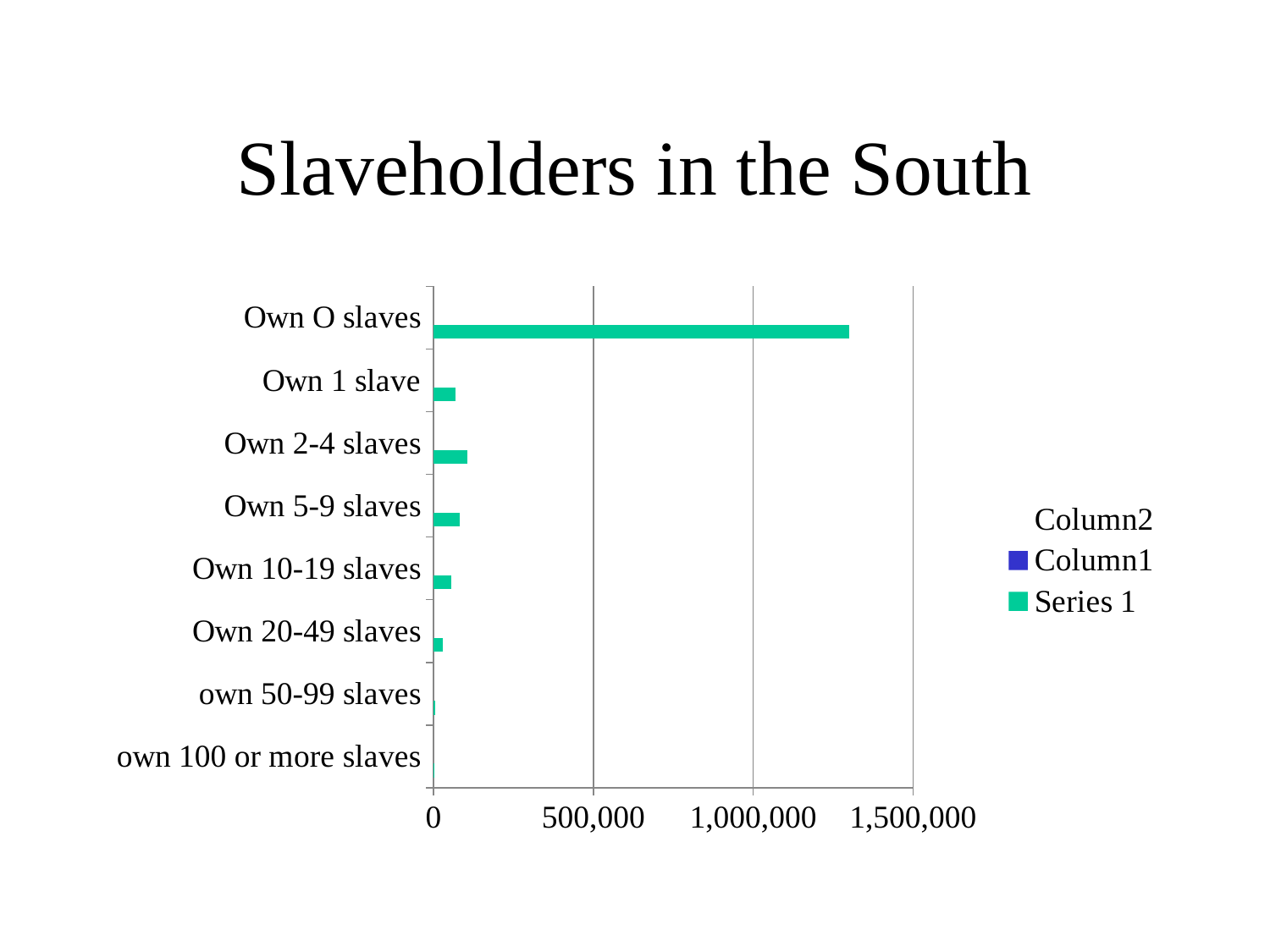
How many series does the legend list? 3 Which is larger, the value for Own 10-19 slaves or the value for Own 20-49 slaves? Own 10-19 slaves What is the title of the chart? Slaveholders in the South Is the value for Own O slaves greater or less than 1,000,000? greater Which category has the highest value? Own O slaves Which is larger, the value for Own 1 slave or the value for Own 2-4 slaves? Own 2-4 slaves Which is larger, the value for Own O slaves or the value for Own 5-9 slaves? Own O slaves Which legend entry do the plotted bars belong to? Series 1 What kind of chart is shown on the slide? bar chart Is the value for Own 2-4 slaves greater or less than 500,000? less How many categories are shown on the chart? 8 Is the value for Own O slaves greater or less than 1,500,000? less